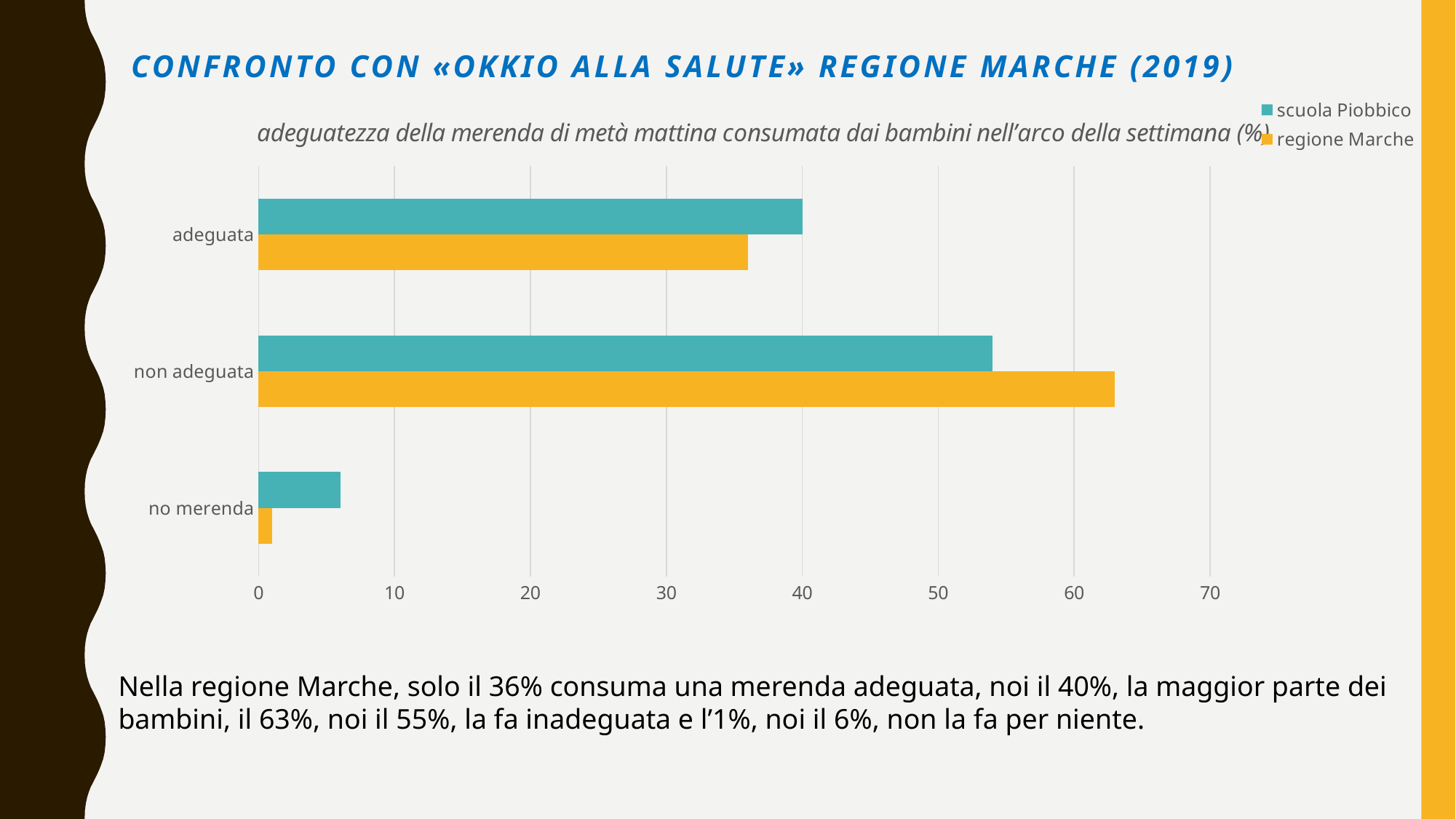
What is the value for scuola Piobbico in the 'adeguata' category? 40 Which category has the highest value for regione Marche? non adeguata Which series is shown in yellow in the chart? regione Marche In the 'adeguata' category, which series has the larger value, scuola Piobbico or regione Marche? scuola Piobbico In the 'non adeguata' category, which series has the larger value, scuola Piobbico or regione Marche? regione Marche Is the value for regione Marche in the 'adeguata' category greater or less than 40? less What kind of chart is shown on the slide? bar chart Which category has the lowest value for regione Marche? no merenda How many categories are shown on the vertical axis of the chart? 3 Is the value for scuola Piobbico in the 'no merenda' category greater or less than 10? less How many series does the legend list? 2 Is the value for regione Marche in the 'non adeguata' category greater or less than 60? greater